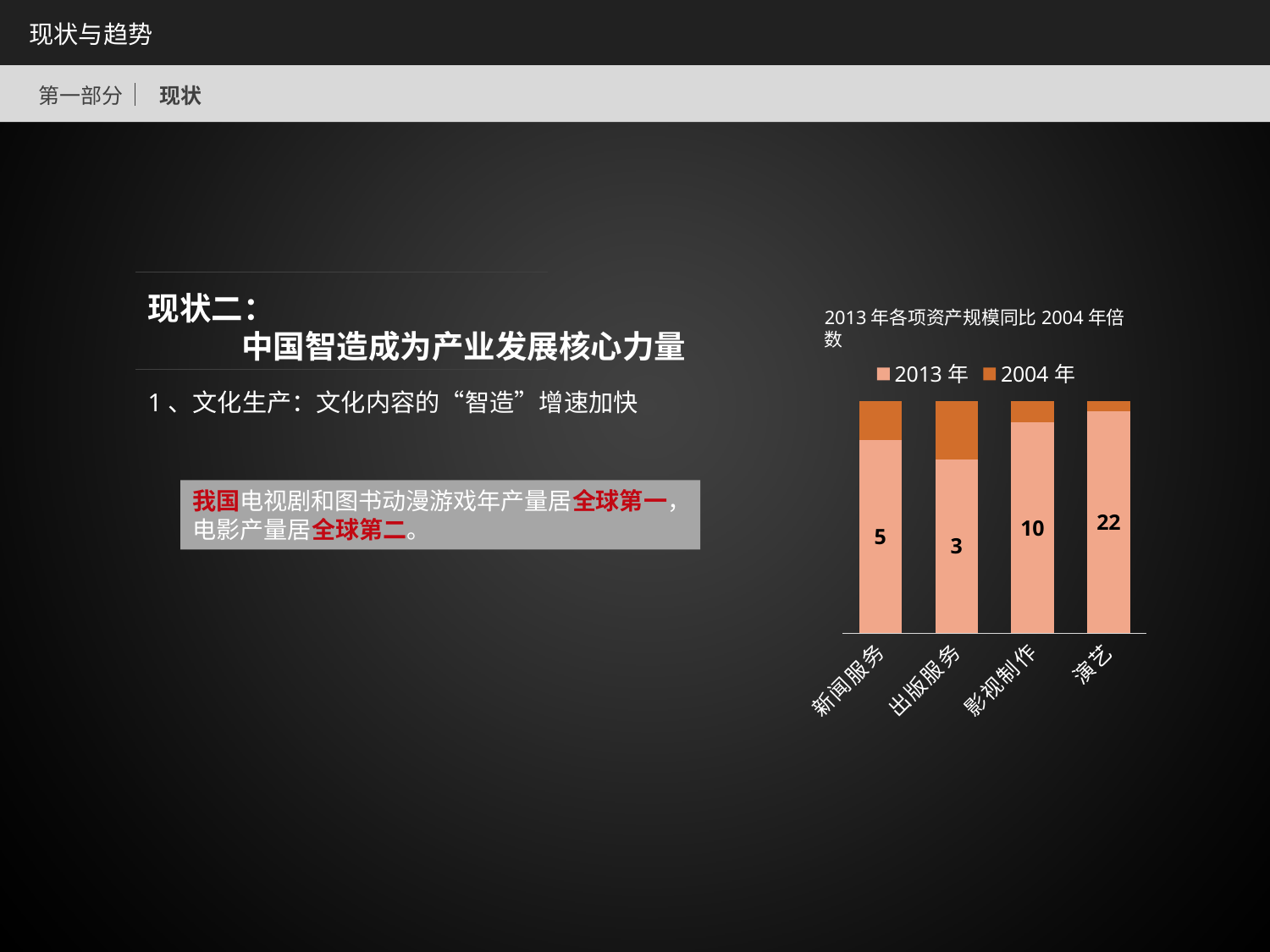
What is the 2013 年 value for 影视制作? 10 What is the 2013 年 value for 新闻服务? 5 What is the 2013 年 value for 演艺? 22 What is the difference between the 2013 年 values for 影视制作 and 出版服务? 7 Which has a larger 2013 年 value, 影视制作 or 新闻服务? 影视制作 How many series does the chart legend list? 2 What is the difference between the 2013 年 values for 演艺 and 新闻服务? 17 What is the 2013 年 value for 出版服务? 3 How many categories are shown on the x axis of the chart? 4 What kind of chart is shown on the slide? Stacked bar chart Which category has the highest 2013 年 value? 演艺 Which category has the lowest 2013 年 value? 出版服务